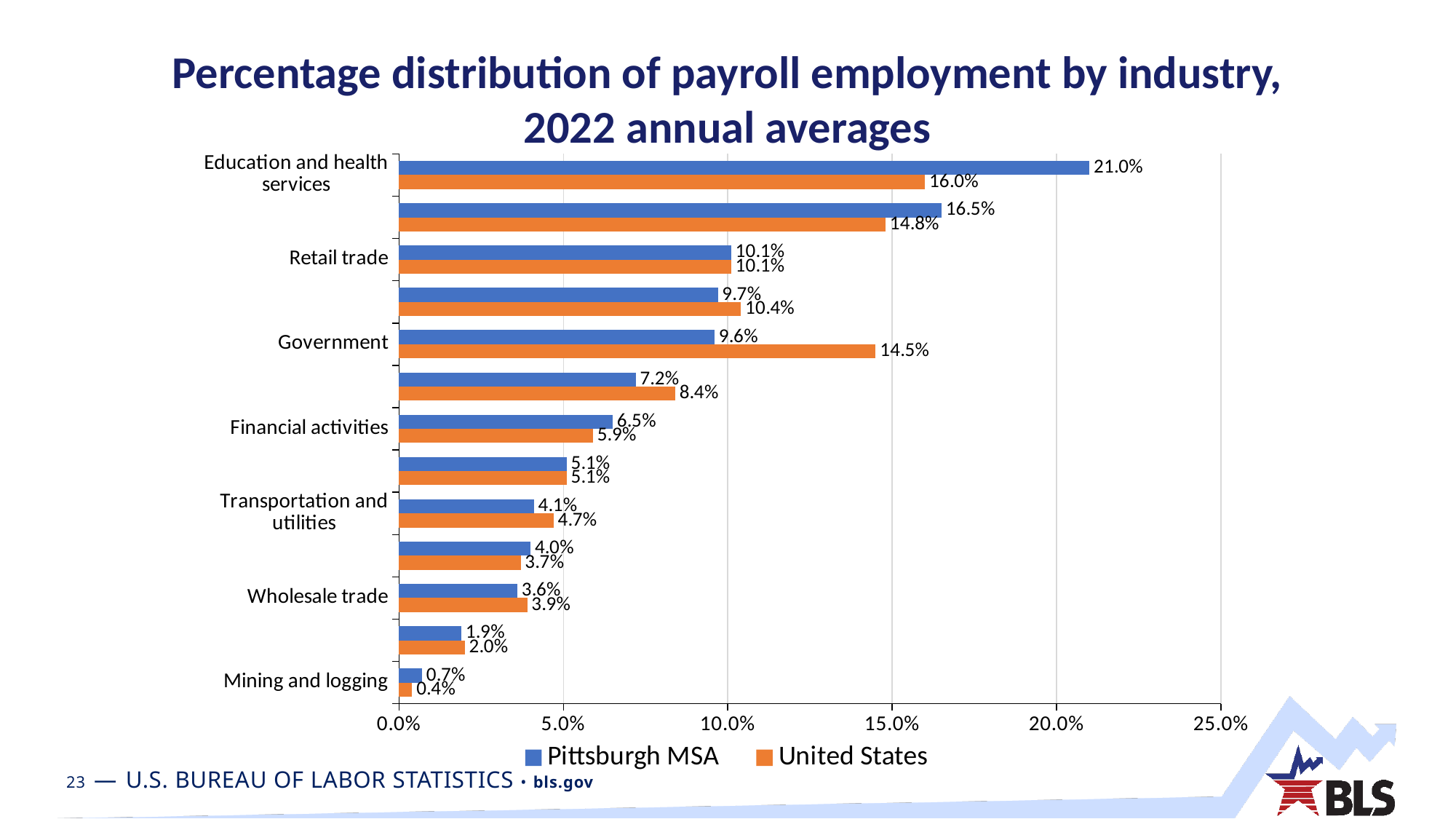
For Government, which is larger: the Pittsburgh MSA value or the United States value? United States What is the United States value for Government? 14.5% Which industry has the highest Pittsburgh MSA share? Education and health services What is the United States value for Mining and logging? 0.4% What is the Pittsburgh MSA value for Financial activities? 6.5% Which industry has the lowest United States share? Mining and logging What kind of chart is shown on the slide? Bar chart How many series does the legend list? 2 What is the difference between the Pittsburgh MSA and United States values for Education and health services? 5.0% For Wholesale trade, which is larger: the Pittsburgh MSA value or the United States value? United States What colour are the United States bars? Orange What is the Pittsburgh MSA value for Education and health services? 21.0%